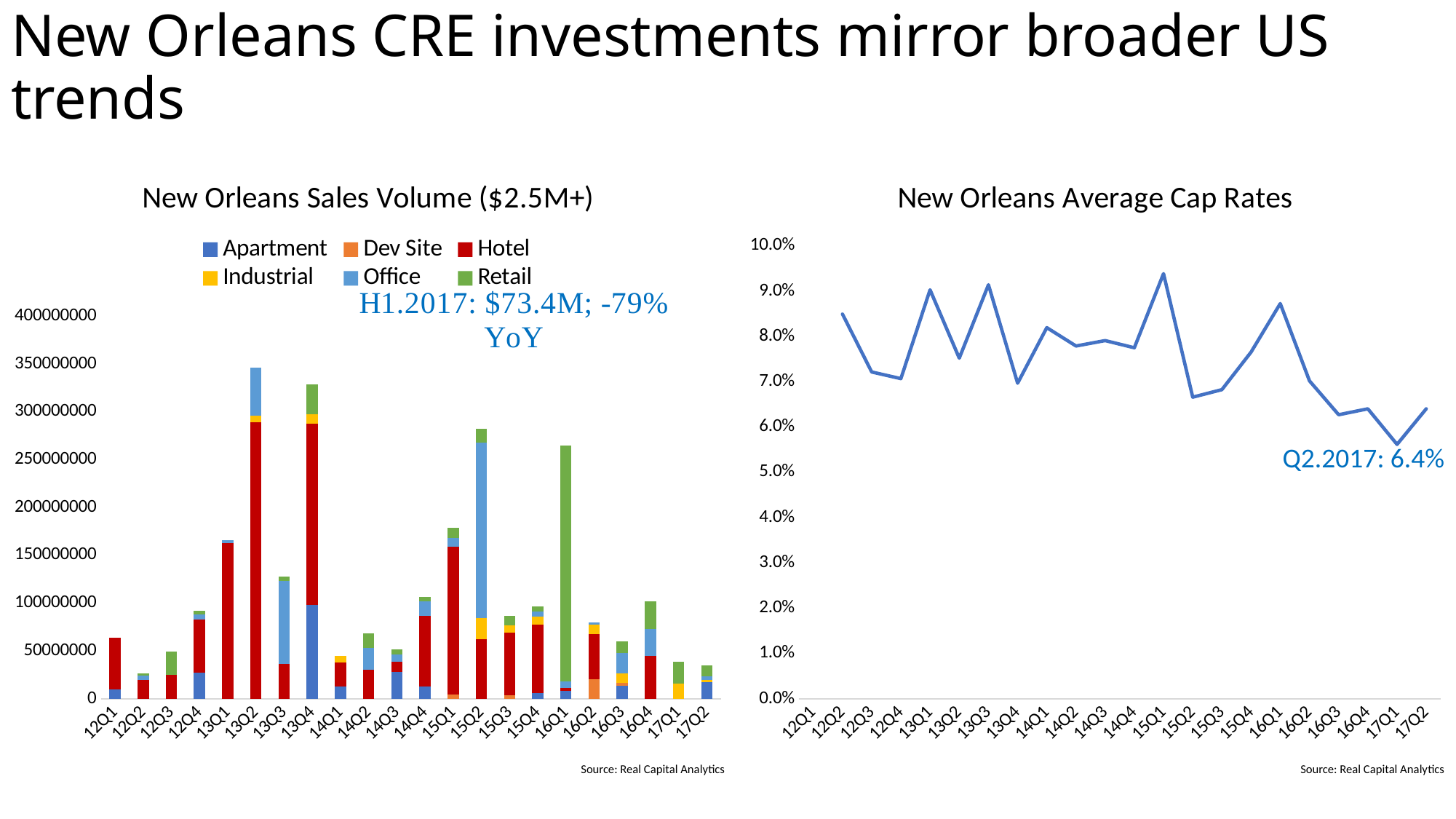
How many series does the legend of the New Orleans Sales Volume ($2.5M+) chart list? 6 In the New Orleans Sales Volume ($2.5M+) chart, which total bar is larger, 13Q2 or 15Q2? 13Q2 In the New Orleans Average Cap Rates chart, is the value for 17Q1 greater or less than 6.0%? less In the New Orleans Sales Volume ($2.5M+) chart, is the total bar for 13Q2 greater or less than 300000000? greater In the New Orleans Average Cap Rates chart, what is the cap rate for Q2.2017? 6.4% What kind of chart is the New Orleans Average Cap Rates chart? line chart According to the annotation on the New Orleans Sales Volume ($2.5M+) chart, what was the H1.2017 sales volume? $73.4M In the New Orleans Sales Volume ($2.5M+) chart, which quarter has the tallest stacked bar? 13Q2 In the New Orleans Average Cap Rates chart, do cap rates generally rise or fall from 16Q1 to 17Q1? fall What kind of chart is the New Orleans Sales Volume ($2.5M+) chart? bar chart In the New Orleans Sales Volume ($2.5M+) chart, is the total bar for 17Q1 greater or less than 50000000? less In the New Orleans Average Cap Rates chart, which quarter has the lowest cap rate? 17Q1